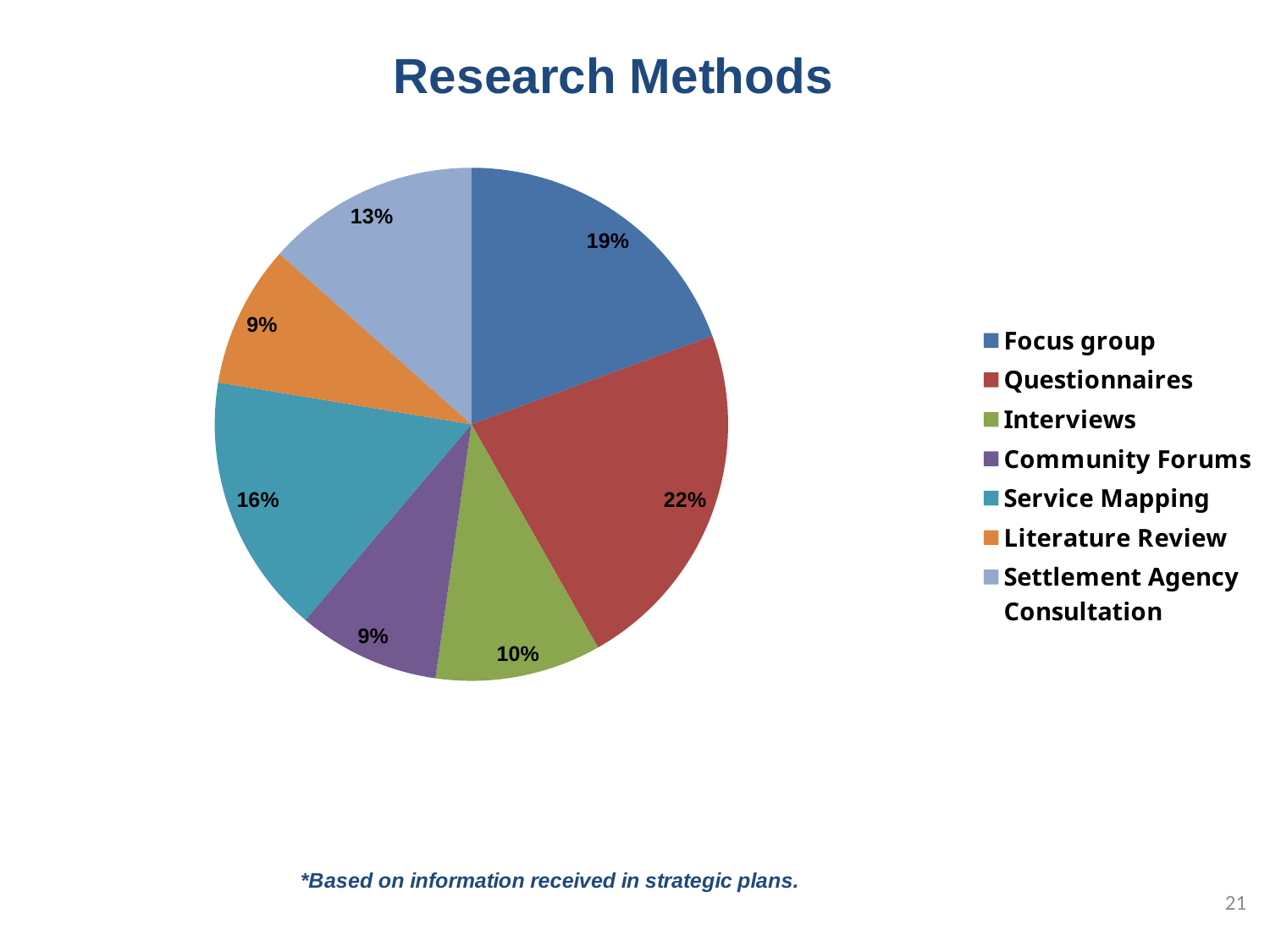
What share of the pie does Questionnaires represent? 22% What is the difference in percentage points between Questionnaires and Focus group? 3 What percentage is shown for Settlement Agency Consultation? 13% What percentage is shown for Service Mapping? 16% What type of chart is shown on the slide? Pie chart Which is larger, the share for Settlement Agency Consultation or the share for Literature Review? Settlement Agency Consultation What percentage is shown for Focus group? 19% What is the difference in percentage points between Service Mapping and Interviews? 6 Which research method has the largest slice of the pie? Questionnaires What is the title of the chart? Research Methods What percentage is shown for Interviews? 10% How many research methods are shown in the pie chart? 7